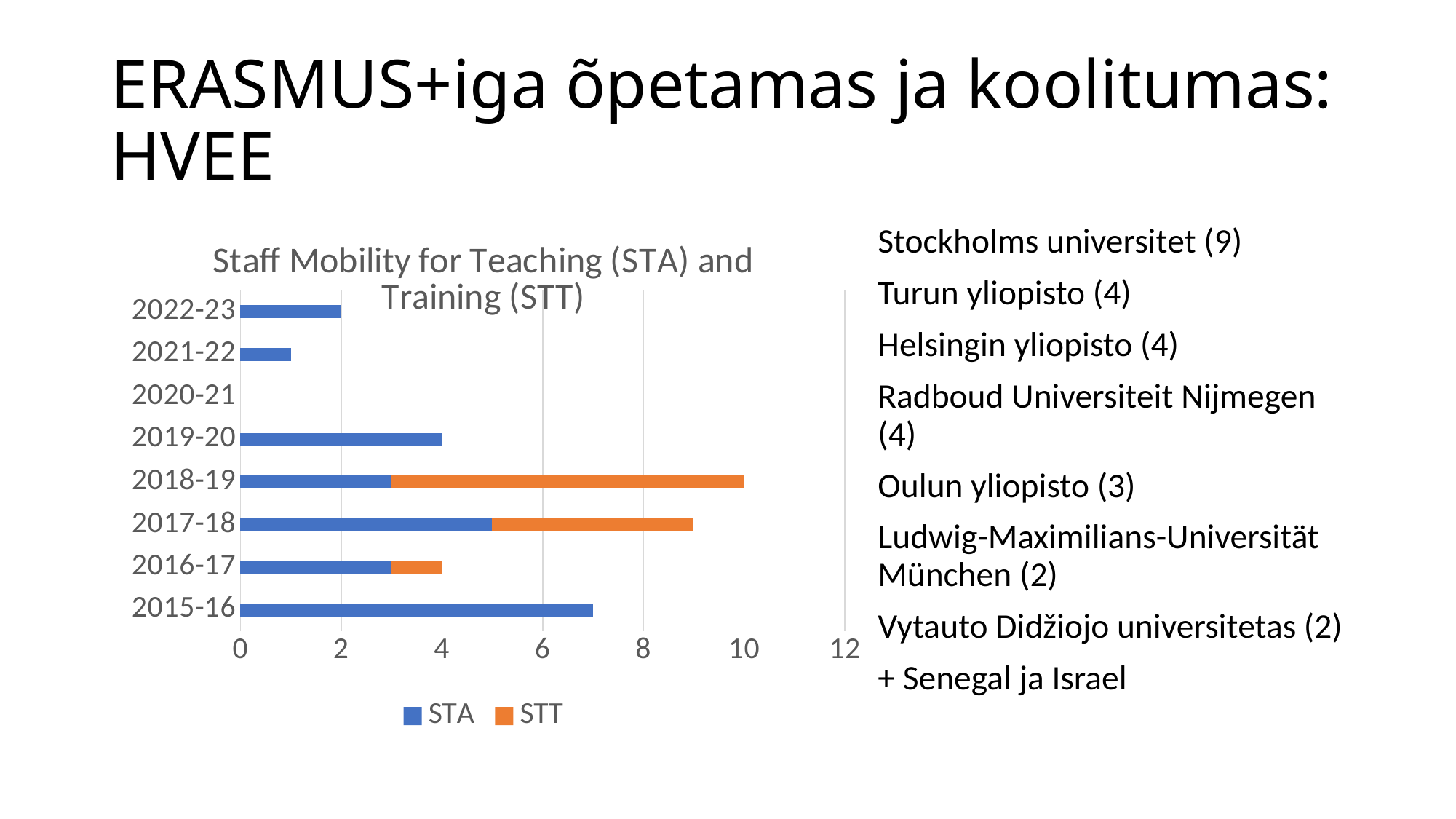
Is the STA value for 2015-16 greater or less than 6? greater What is the STA value for 2019-20? 4 What is the difference between the total bar for 2018-19 and the total bar for 2016-17? 6 What is the total of the stacked bar for 2018-19? 10 What is the title of the chart? Staff Mobility for Teaching (STA) and Training (STT) Which academic year has the longest total bar? 2018-19 Which has the larger STA value, 2015-16 or 2019-20? 2015-16 What is the STA value for 2022-23? 2 What is the total of the stacked bar for 2016-17? 4 What type of chart is shown on the slide? bar chart How many series does the chart legend list? 2 How many academic years are shown on the chart's vertical axis? 8